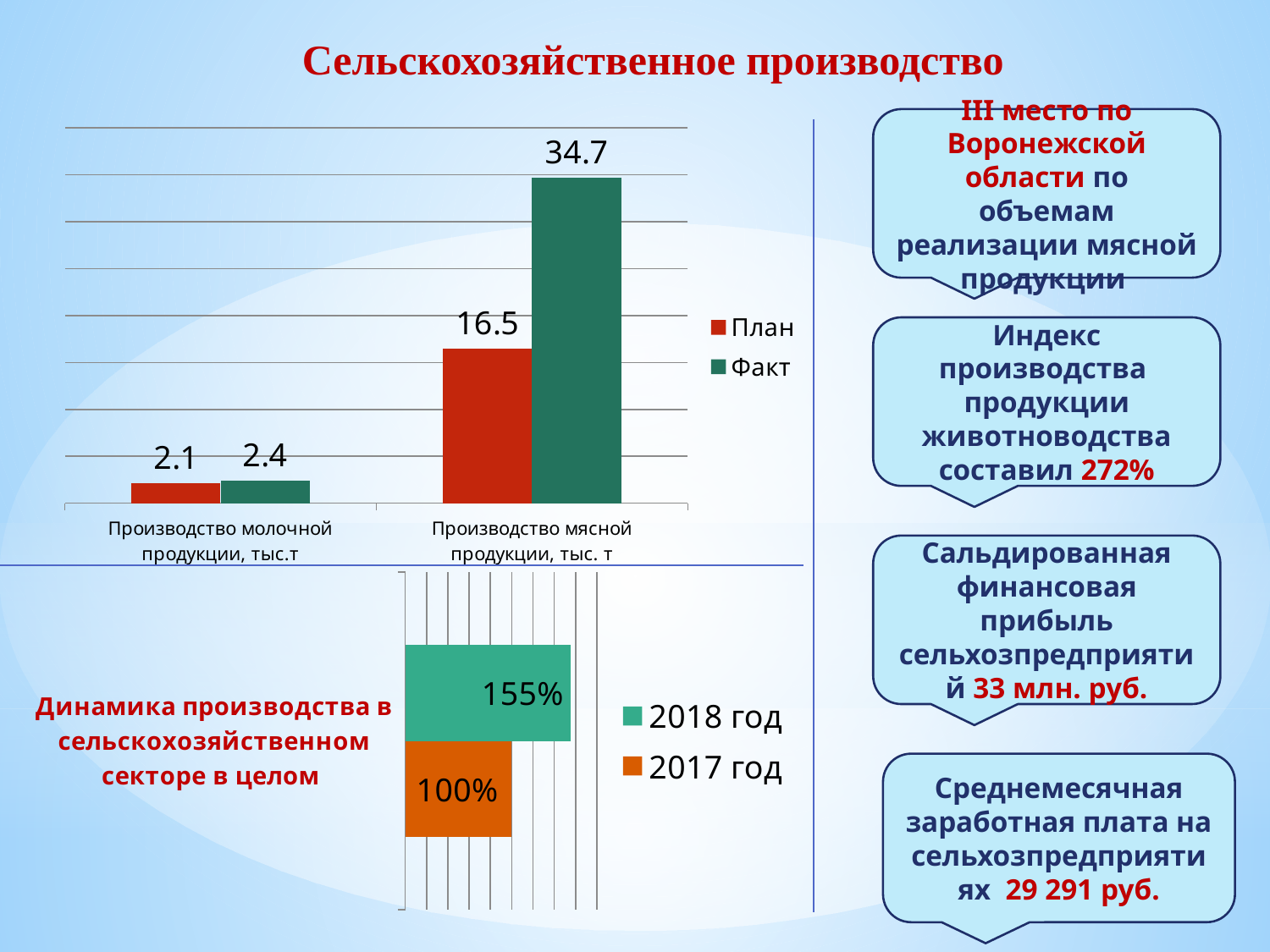
In the top chart, what is the Факт value for Производство молочной продукции, тыс.т? 2.4 In the top chart, what is the Факт value for Производство мясной продукции, тыс. т? 34.7 In the top chart, what is the План value for Производство мясной продукции, тыс. т? 16.5 In the top chart, which is larger for Производство молочной продукции: План or Факт? Факт In the bottom chart, what is the value for 2018 год? 155% How many categories are shown on the x axis of the top chart? 2 In the top chart, what is the План value for Производство молочной продукции, тыс.т? 2.1 In the bottom chart, what is the difference between the 2018 год and 2017 год values? 55% In the top chart, which bar has the highest value? Факт for Производство мясной продукции (34.7) In the top chart, what is the difference between the Факт and План values for Производство мясной продукции? 18.2 What type of chart is the bottom chart? Bar chart How many series does the legend of the top chart list? 2